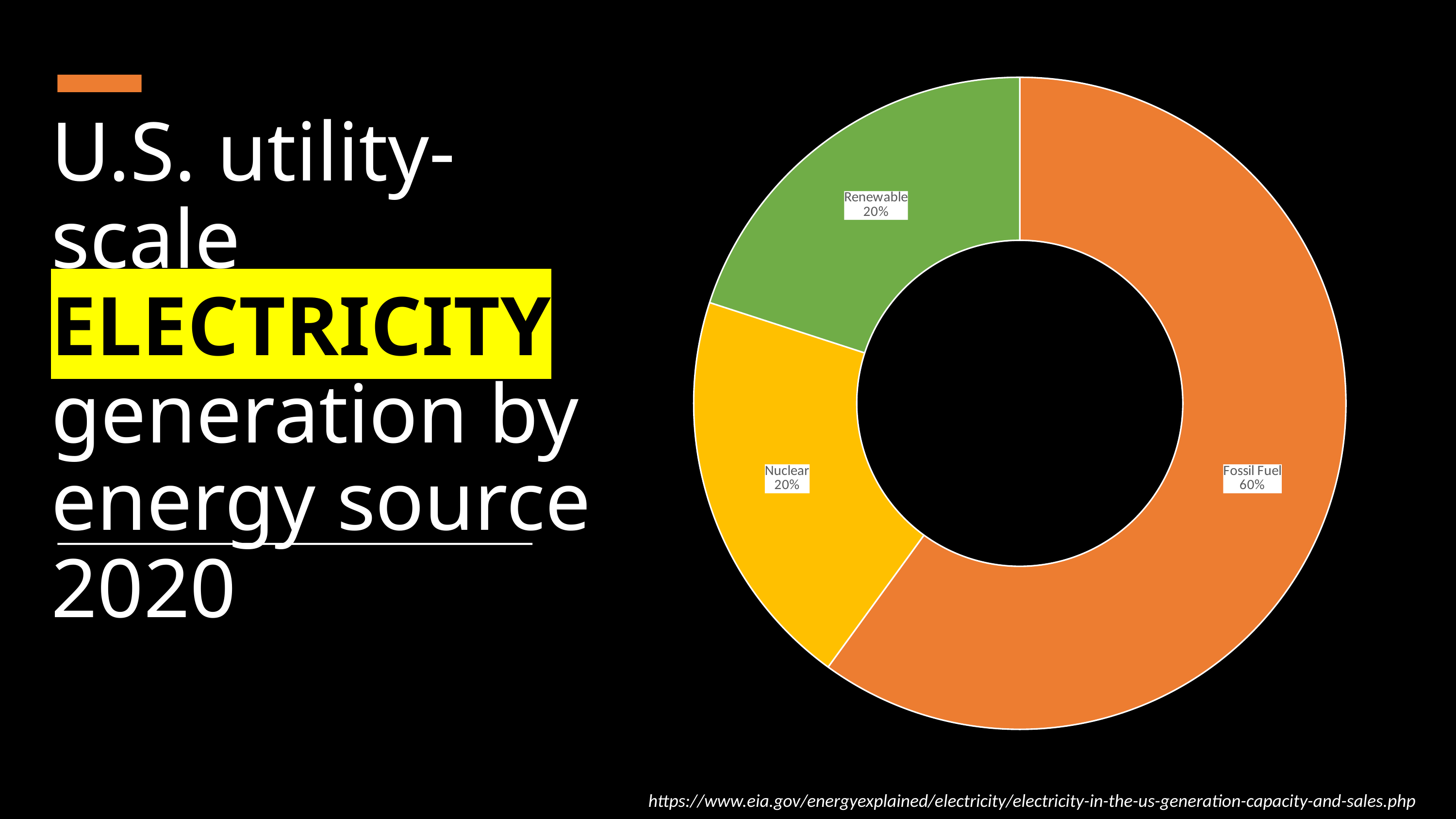
What share of U.S. utility-scale electricity generation comes from Nuclear? 20% What colour is the Nuclear slice? Yellow What share of U.S. utility-scale electricity generation comes from Renewable? 20% Which energy source has the largest share of the chart? Fossil Fuel What kind of chart is shown on the slide? Doughnut (pie) chart What is the combined share of Nuclear and Renewable? 40% Which is larger, the Fossil Fuel share or the Renewable share? Fossil Fuel What share of U.S. utility-scale electricity generation comes from Fossil Fuel? 60% What is the difference between the Fossil Fuel share and the Nuclear share? 40% What colour is the Renewable slice? Green How many energy source categories are shown in the chart? 3